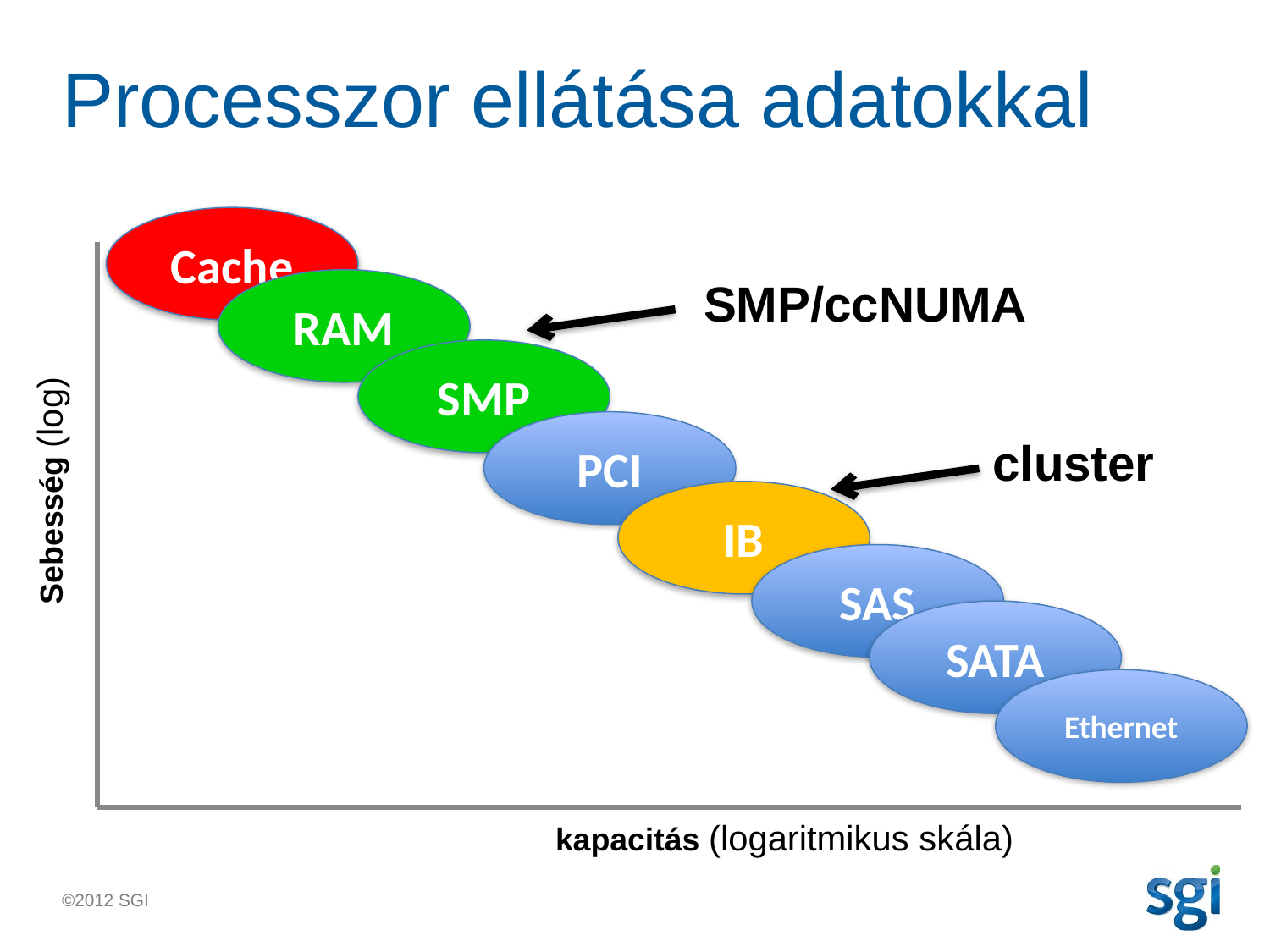
Which item is drawn in a red ellipse? Cache How many labelled ellipses are plotted on the chart? 8 Which item is shown with the smallest capacity (furthest left on the kapacitás axis)? Cache Which is placed further right on the capacity axis, PCI or IB? IB Which item is shown with the largest capacity (furthest right on the kapacitás axis)? Ethernet Which item is placed lowest on the speed (Sebesség) axis? Ethernet As capacity increases along the x axis, does speed rise or fall? fall Which item is placed highest on the speed (Sebesség) axis? Cache What is the label of the horizontal axis? kapacitás (logaritmikus skála) What is the label of the vertical axis? Sebesség (log) Which item is drawn in an orange/yellow ellipse? IB Which is placed higher on the speed axis, RAM or SATA? RAM